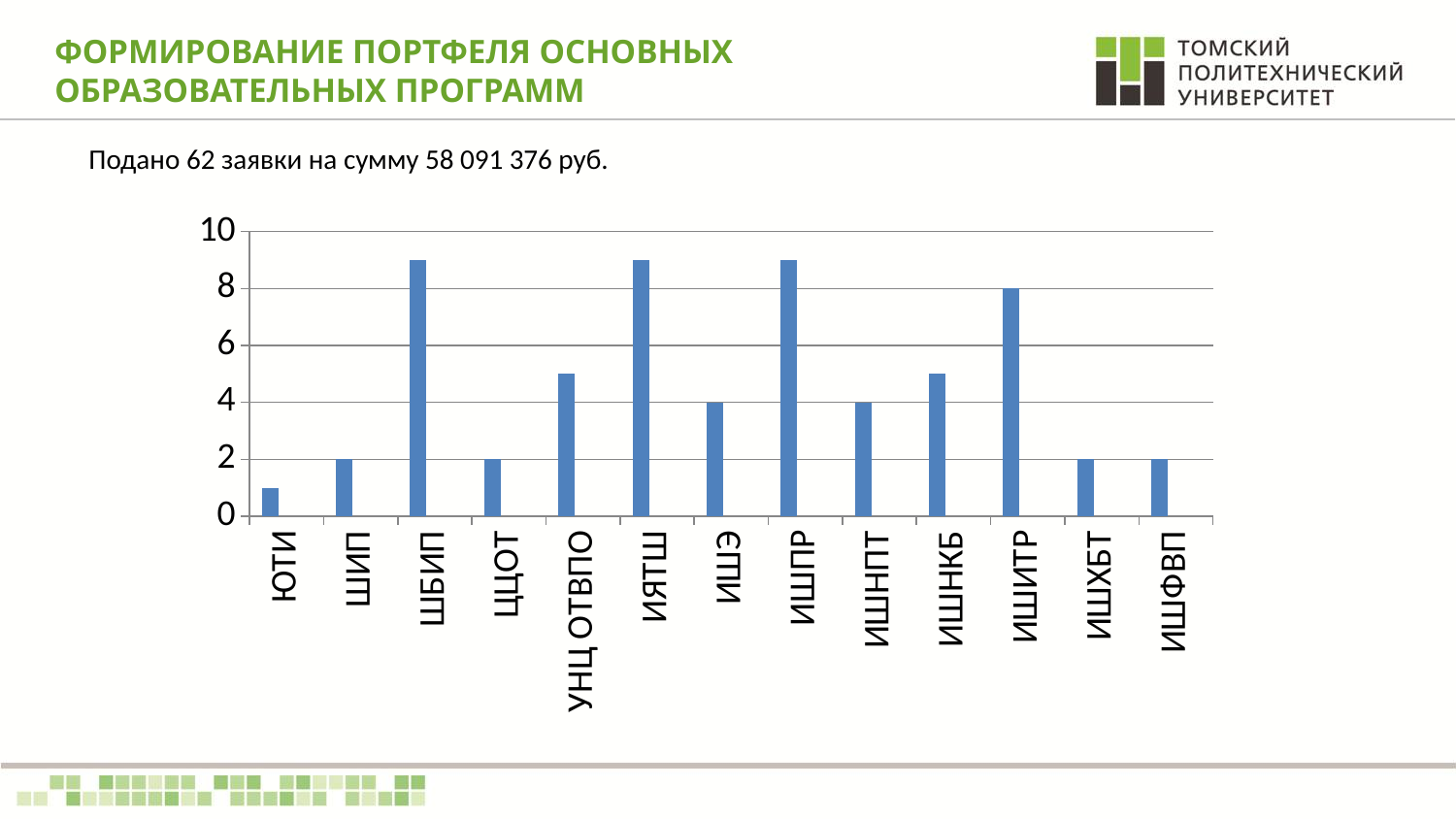
What is the value for ИШИТР? 8 How many categories are shown on the x axis of the chart? 13 Which category has the lowest value? ЮТИ Is the value for ШБИП greater or less than 8? greater What kind of chart is shown on the slide? bar chart What is the value for ИШФВП? 2 What is the value for ШИП? 2 What is the value for ИШНПТ? 4 Is the value for УНЦ ОТВПО greater or less than 4? greater